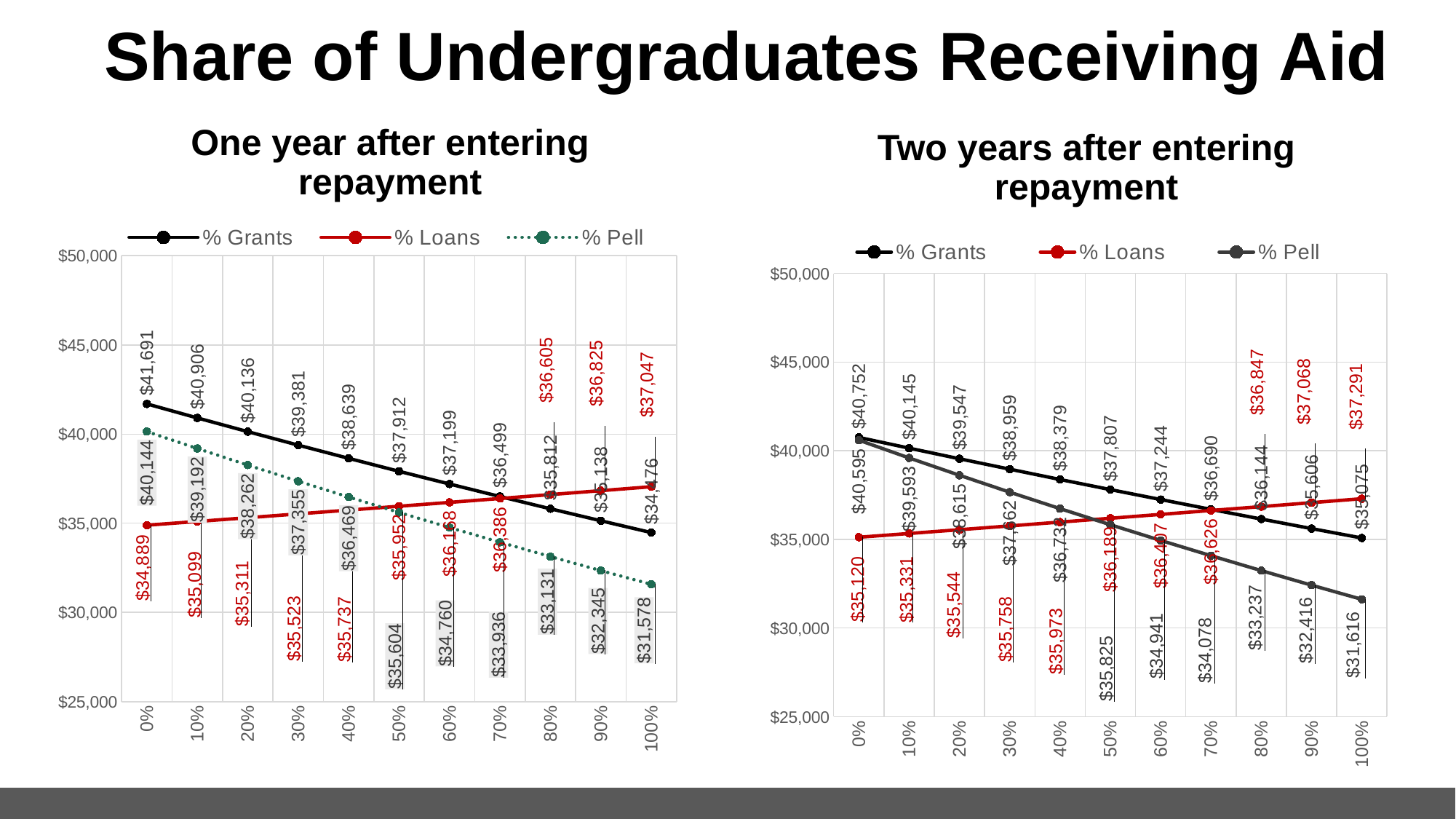
What kind of chart is the 'One year after entering repayment' chart? Line chart In the 'One year after entering repayment' chart, what is the difference between % Grants and % Pell at 0%? $1,547 In the 'Two years after entering repayment' chart, does the % Pell series rise or fall from 0% to 100%? Falls In the 'One year after entering repayment' chart, what is the value of % Grants at 0%? $41,691 In the 'One year after entering repayment' chart, what is the value of % Pell at 100%? $31,578 In the 'Two years after entering repayment' chart, what is the value of % Grants at 50%? $37,807 In the 'Two years after entering repayment' chart, what is the value of % Loans at 100%? $37,291 In the 'Two years after entering repayment' chart, which is larger at 100%: % Grants or % Loans? % Loans In the 'Two years after entering repayment' chart, at which x-axis value is % Grants highest? 0% How many points along the x axis does the 'One year after entering repayment' chart have? 11 How many series does the legend of the 'Two years after entering repayment' chart list? 3 In the 'One year after entering repayment' chart, does the % Loans series rise or fall from 0% to 100%? Rises